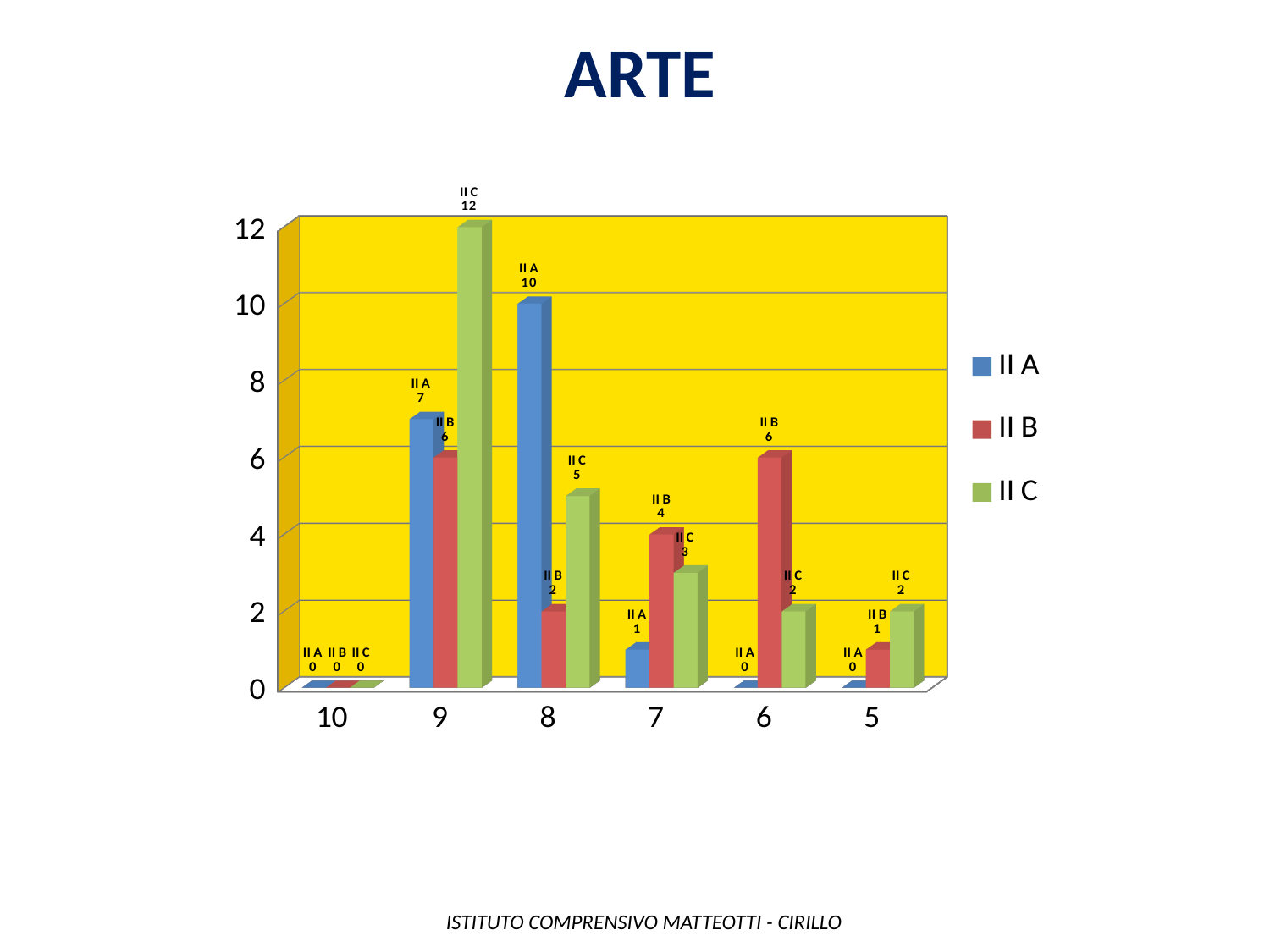
What is the value for II B at grade 6? 6 What is the difference between II A and II B at grade 8? 8 What is the title of the chart? ARTE What is the value for II A at grade 8? 10 Which is larger at grade 7: II B or II C? II B Which series has the highest value at grade 9? II C How many series does the legend list? 3 What is the value for II C at grade 5? 2 Which series has the lowest value at grade 8? II B How many grade categories are shown on the x axis? 6 What is the value for II C at grade 9? 12 What kind of chart is shown? bar chart